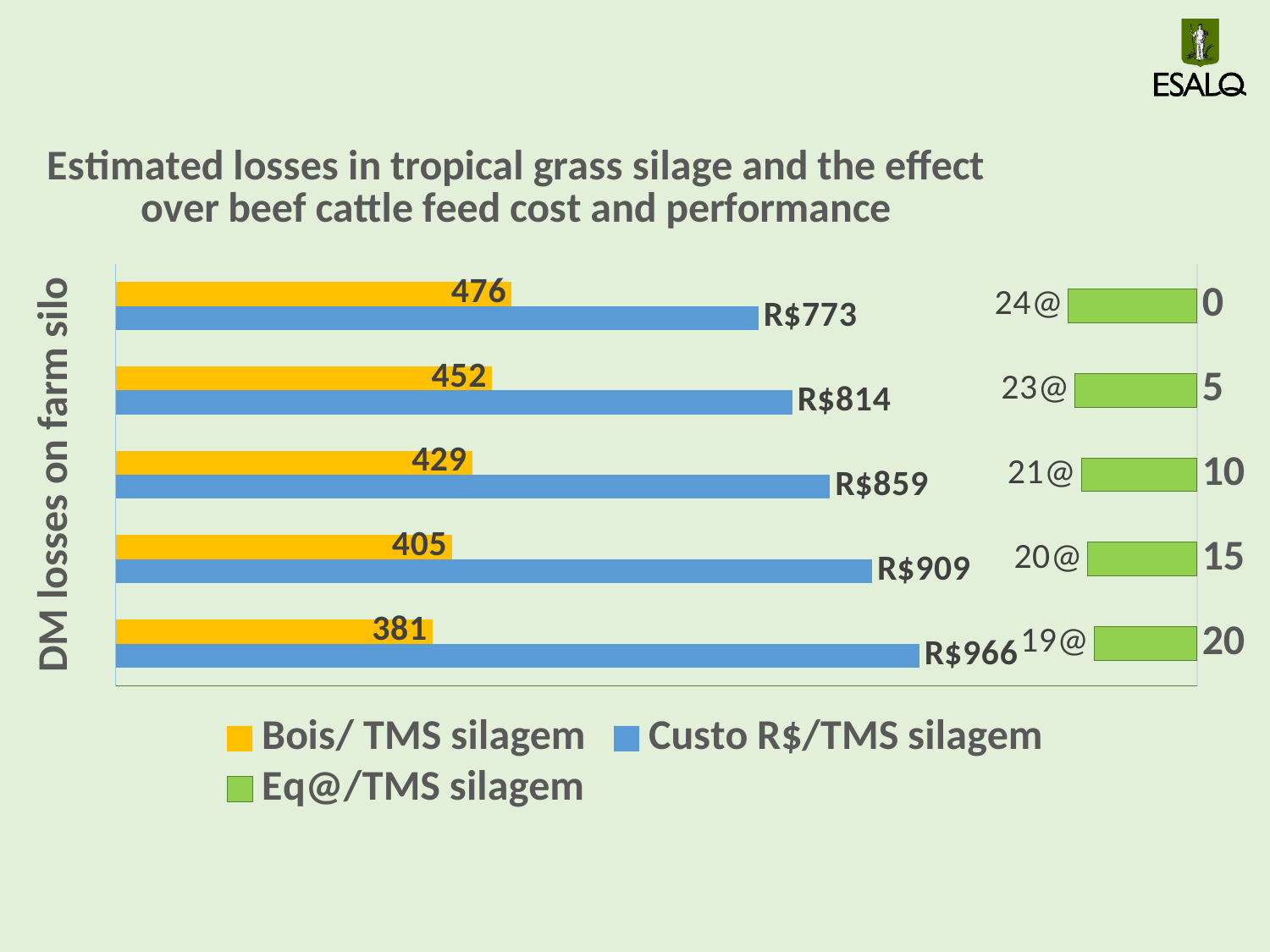
What is the value of Eq@/TMS silagem at 10% DM losses? 21@ What is the value of Custo R$/TMS silagem at 20% DM losses? R$966 What kind of chart is shown on the slide? Bar chart How many series does the legend list? 3 At which DM loss level is Custo R$/TMS silagem lowest? 0 Which is larger: Bois/ TMS silagem at 5 or at 15 DM losses? 5 What is the value of Custo R$/TMS silagem at 5% DM losses? R$814 At which DM loss level is Bois/ TMS silagem highest? 0 What is the difference in Bois/ TMS silagem between 0 and 20 DM losses? 95 What is the difference in Custo R$/TMS silagem between 15 and 10 DM losses? R$50 How many DM loss categories are shown on the chart? 5 What is the value of Bois/ TMS silagem at 0% DM losses? 476